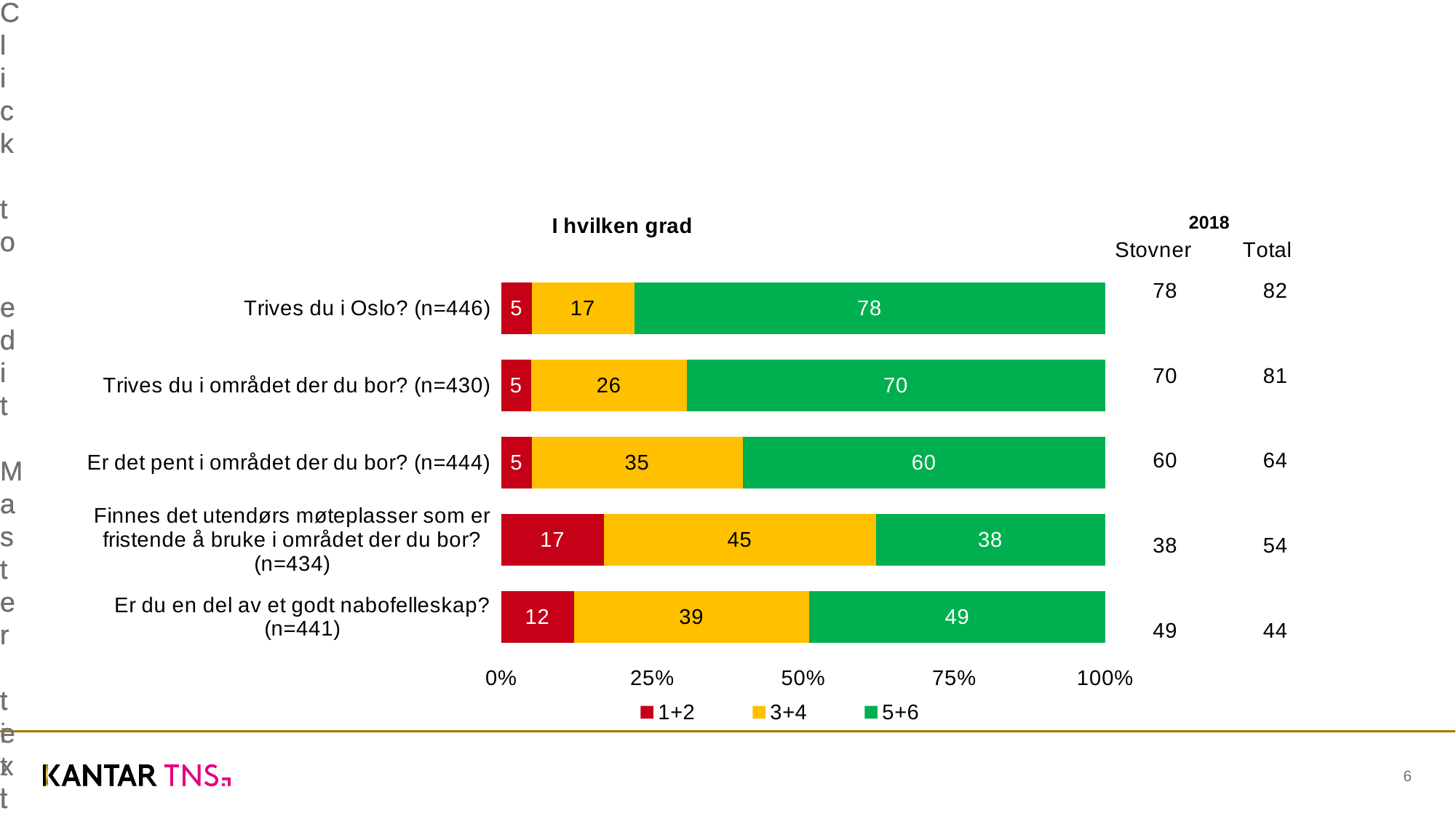
How many categories (questions) are shown in the chart? 5 Which is larger: the 5+6 value for "Trives du i området der du bor? (n=430)" or for "Er det pent i området der du bor? (n=444)"? Trives du i området der du bor? (n=430) What is the title of the chart? I hvilken grad How many series does the legend list? 3 What kind of chart is shown on the slide? Stacked bar chart Which category has the highest value for the 5+6 series? Trives du i Oslo? (n=446) What is the difference between the 3+4 values for "Er du en del av et godt nabofelleskap? (n=441)" and "Trives du i Oslo? (n=446)"? 22 What is the value of the 1+2 series for "Finnes det utendørs møteplasser som er fristende å bruke i området der du bor? (n=434)"? 17 What is the total of the stacked bar for "Er du en del av et godt nabofelleskap? (n=441)"? 100 What is the value of the 3+4 series for "Er det pent i området der du bor? (n=444)"? 35 Which category has the lowest value for the 5+6 series? Finnes det utendørs møteplasser som er fristende å bruke i området der du bor? (n=434) What is the value of the 5+6 series for "Trives du i Oslo? (n=446)"? 78